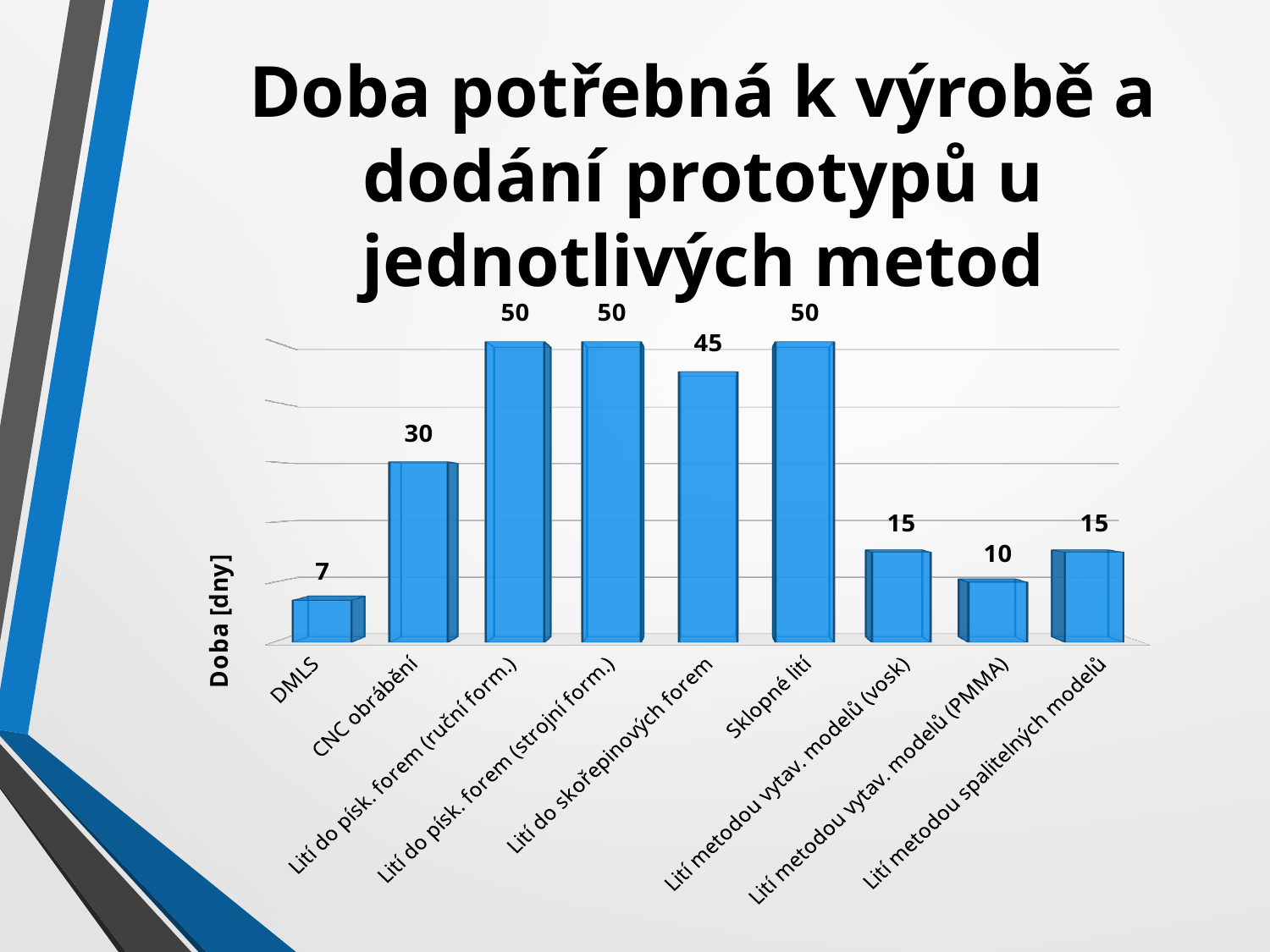
What kind of chart is shown on the slide? Bar chart What is the value for Lití metodou vytav. modelů (PMMA)? 10 What is the label of the vertical axis? Doba [dny] What is the difference between the values for Sklopné lití and Lití do skořepinových forem? 5 What is the value for Sklopné lití? 50 What is the value for Lití do skořepinových forem? 45 Which category has the lowest value? DMLS What is the value for CNC obrábění? 30 How many categories are shown on the x axis? 9 What is the value for DMLS? 7 What is the difference between the values for CNC obrábění and DMLS? 23 Which is larger, the value for Lití metodou vytav. modelů (vosk) or the value for Lití metodou vytav. modelů (PMMA)? Lití metodou vytav. modelů (vosk)